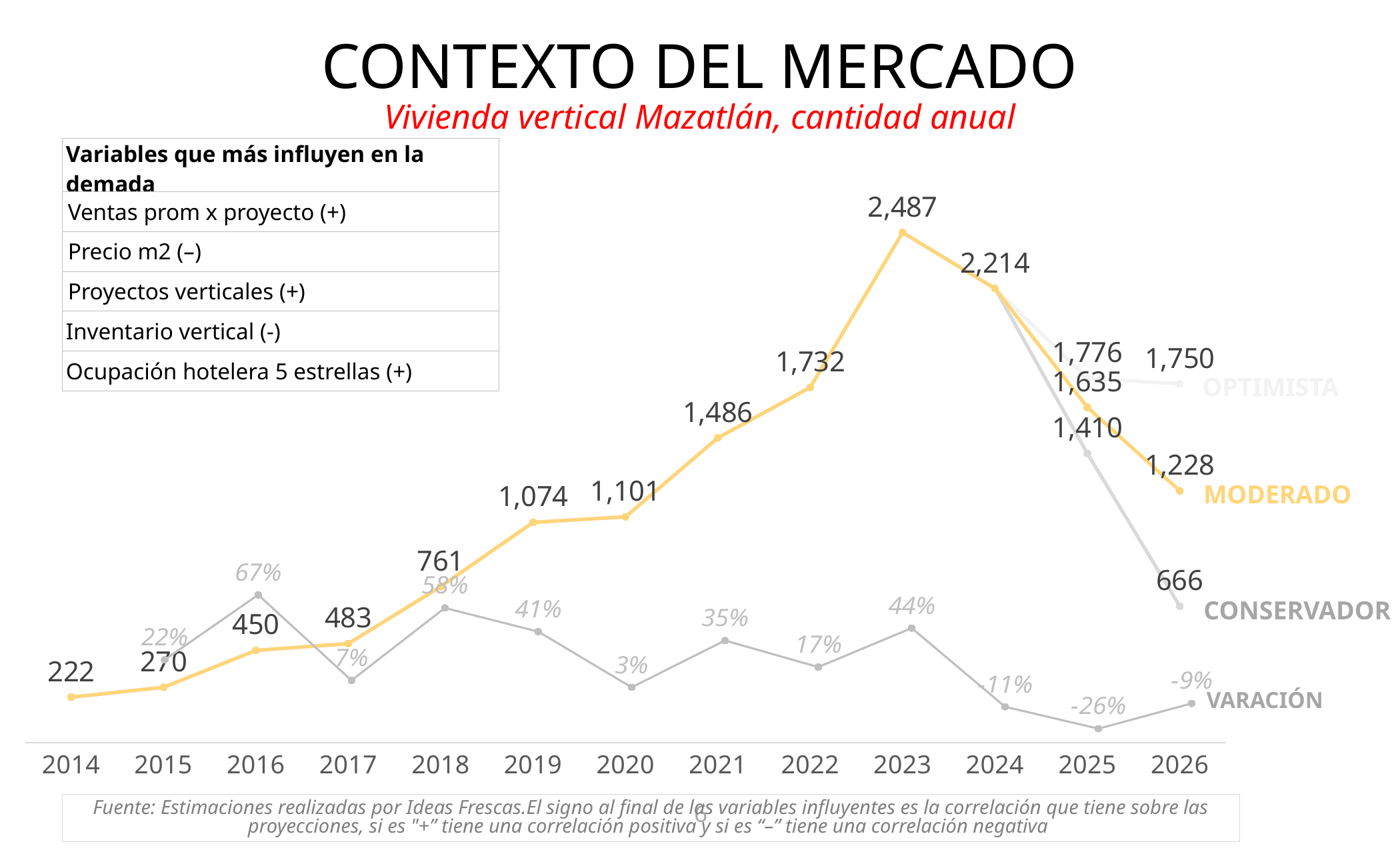
What is the difference between the 2023 value (2,487) and the 2024 value (2,214)? 273 What is the value for 2023 on the main line? 2,487 Which is larger in 2026, the OPTIMISTA value or the CONSERVADOR value? OPTIMISTA What is the OPTIMISTA value for 2025? 1,776 What type of chart is shown on the slide? line chart How many years are shown on the x axis? 13 What is the MODERADO value for 2026? 1,228 Which year has the highest value on the main line? 2023 Does the main line rise or fall from 2014 to 2023? rise What is the VARACIÓN percentage for 2016? 67% What is the CONSERVADOR value for 2026? 666 What is the value for 2014? 222